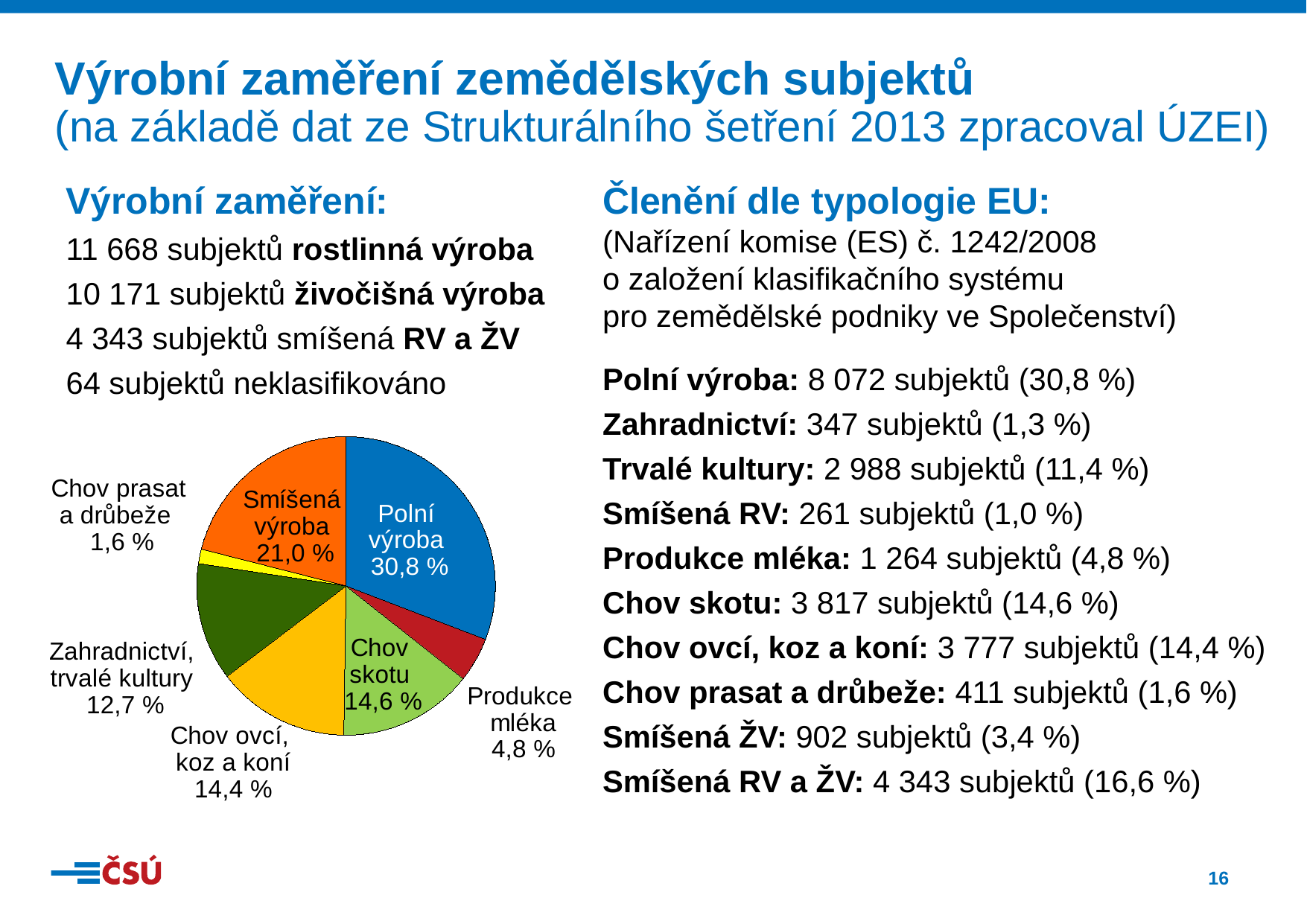
What is the value shown for Chov skotu in the pie chart? 14,6 % Which is larger in the pie chart, Smíšená výroba or Chov skotu? Smíšená výroba What colour is the Polní výroba slice in the pie chart? Blue What percentage is shown for Zahradnictví, trvalé kultury? 12,7 % What is the difference in percentage points between Polní výroba and Smíšená výroba? 9,8 What share of the pie does Polní výroba have? 30,8 % What is the value shown for Smíšená výroba in the pie chart? 21,0 % How many slices are labelled in the pie chart? 7 Which slice of the pie chart is the largest? Polní výroba Which slice of the pie chart is the smallest? Chov prasat a drůbeže What percentage is shown for Produkce mléka? 4,8 % What type of chart is shown on the slide? Pie chart